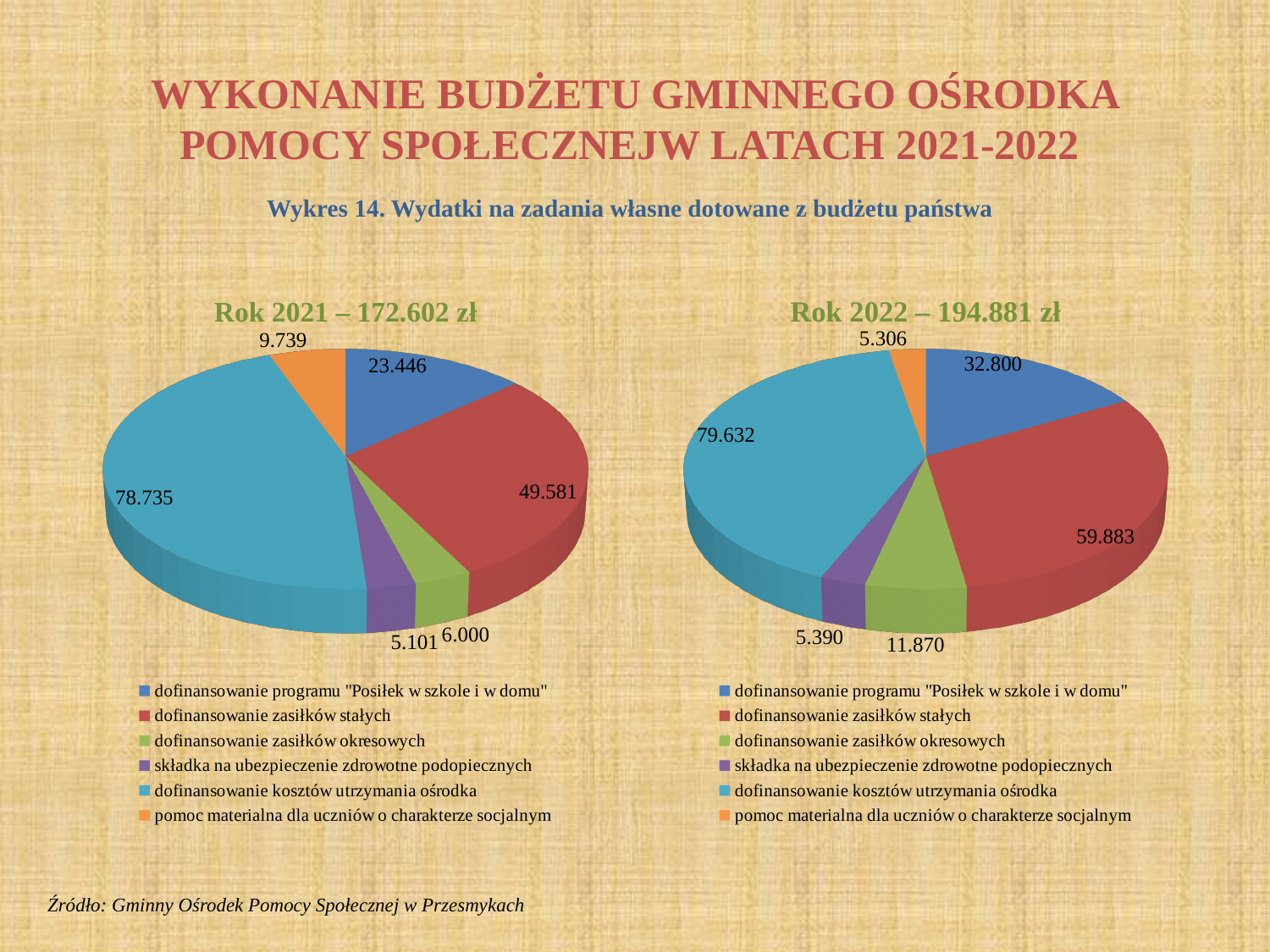
In the Rok 2021 pie chart, which is larger: dofinansowanie programu "Posiłek w szkole i w domu" or pomoc materialna dla uczniów o charakterze socjalnym? dofinansowanie programu "Posiłek w szkole i w domu" In the Rok 2021 pie chart, what share of the total 172.602 zł is dofinansowanie kosztów utrzymania ośrodka (78.735)? 45.6% In the Rok 2022 pie chart, which category has the smallest slice? pomoc materialna dla uczniów o charakterze socjalnym In the Rok 2022 pie chart, what is the value for dofinansowanie zasiłków stałych? 59.883 In the Rok 2021 pie chart, what is the value for dofinansowanie kosztów utrzymania ośrodka? 78.735 In the Rok 2022 pie chart, what is the value for pomoc materialna dla uczniów o charakterze socjalnym? 5.306 What type of chart is used for Rok 2021? pie chart How many slices does the Rok 2022 pie chart have? 6 In the Rok 2021 pie chart, which category has the largest slice? dofinansowanie kosztów utrzymania ośrodka What is the difference between dofinansowanie zasiłków stałych in the Rok 2022 chart and in the Rok 2021 chart? 10.302 What is the total shown in the title of the Rok 2022 pie chart? 194.881 zł In the Rok 2021 pie chart, which category has the smallest slice? składka na ubezpieczenie zdrowotne podopiecznych